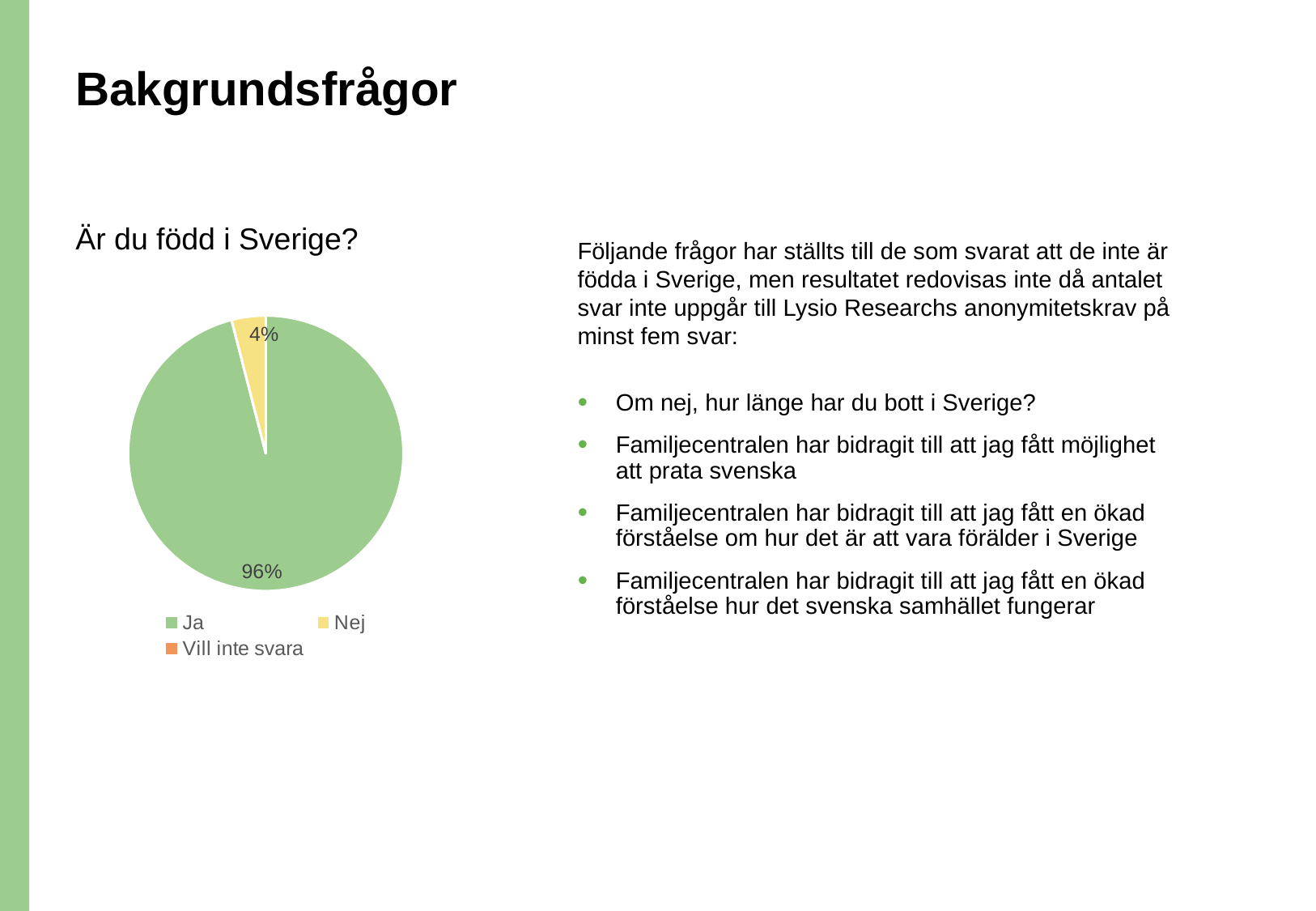
What colour is the "Ja" slice in the pie chart? Green What percentage of respondents answered "Nej" in the pie chart? 4% What kind of chart is shown on the slide? Pie chart Is the value for "Ja" in the pie chart greater or less than 50%? greater What is the title of the pie chart? Är du född i Sverige? What share of the pie does the "Ja" slice represent? 96% Which category has the largest slice in the pie chart? Ja Which is larger in the pie chart, the "Ja" slice or the "Nej" slice? Ja How many categories does the legend of the pie chart list? 3 What is the difference in percentage points between the "Ja" and "Nej" slices? 92 percentage points What percentage of respondents answered "Ja" in the pie chart? 96%